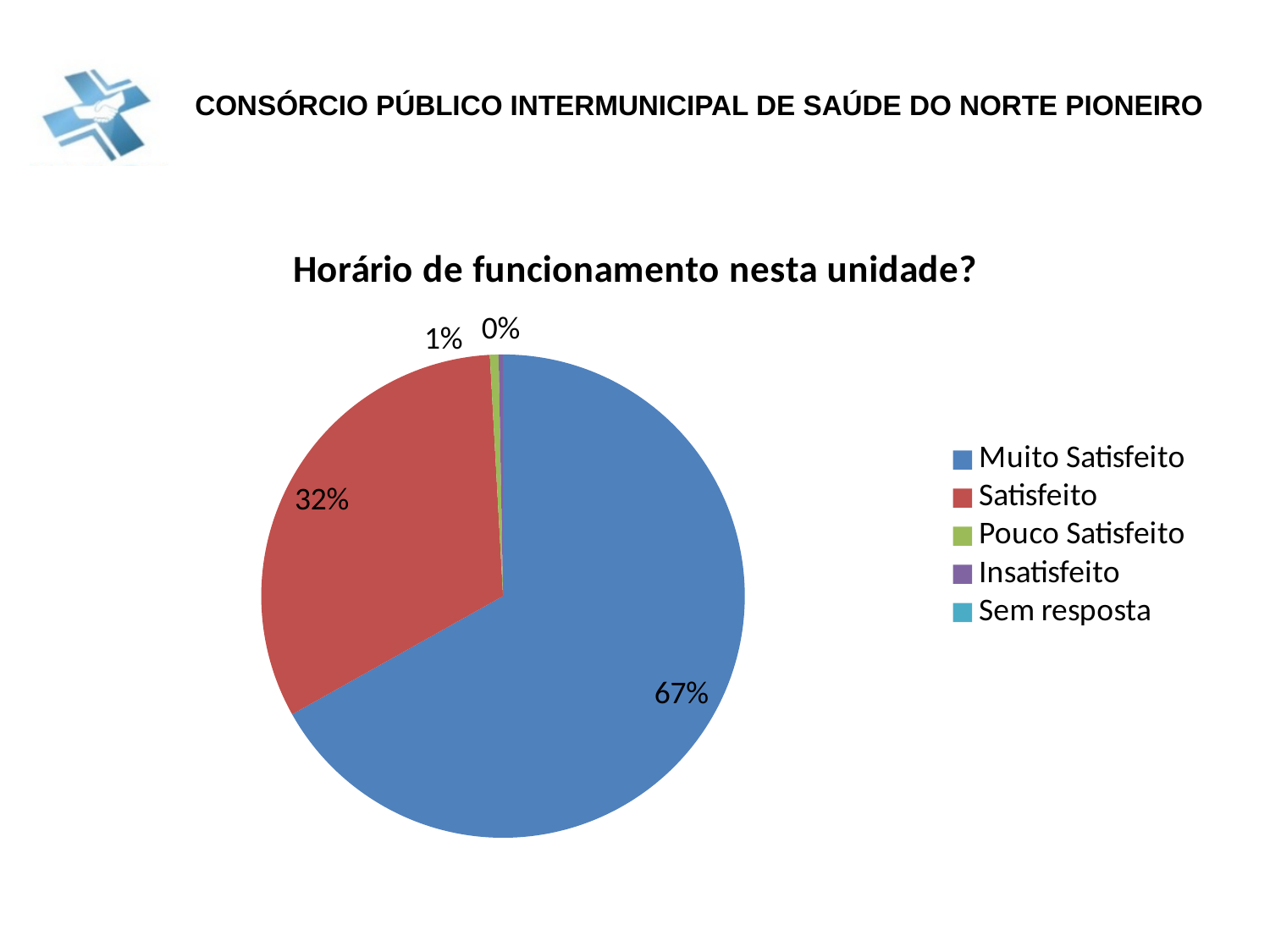
What kind of chart is shown on the slide? Pie chart What share of the pie does the Muito Satisfeito slice represent? 67% What is the difference in percentage points between the Muito Satisfeito and Satisfeito slices? 35 percentage points What is the difference in percentage points between the Satisfeito and Pouco Satisfeito slices? 31 percentage points What percentage of the pie is labelled for Muito Satisfeito? 67% How many categories does the legend list? 5 What colour is the Satisfeito slice in the pie chart? Red What percentage of the pie is labelled for Satisfeito? 32% Which slice is larger, Satisfeito or Pouco Satisfeito? Satisfeito What percentage of the pie is labelled for Pouco Satisfeito? 1% Which category has the largest slice of the pie? Muito Satisfeito What is the title of the chart? Horário de funcionamento nesta unidade?